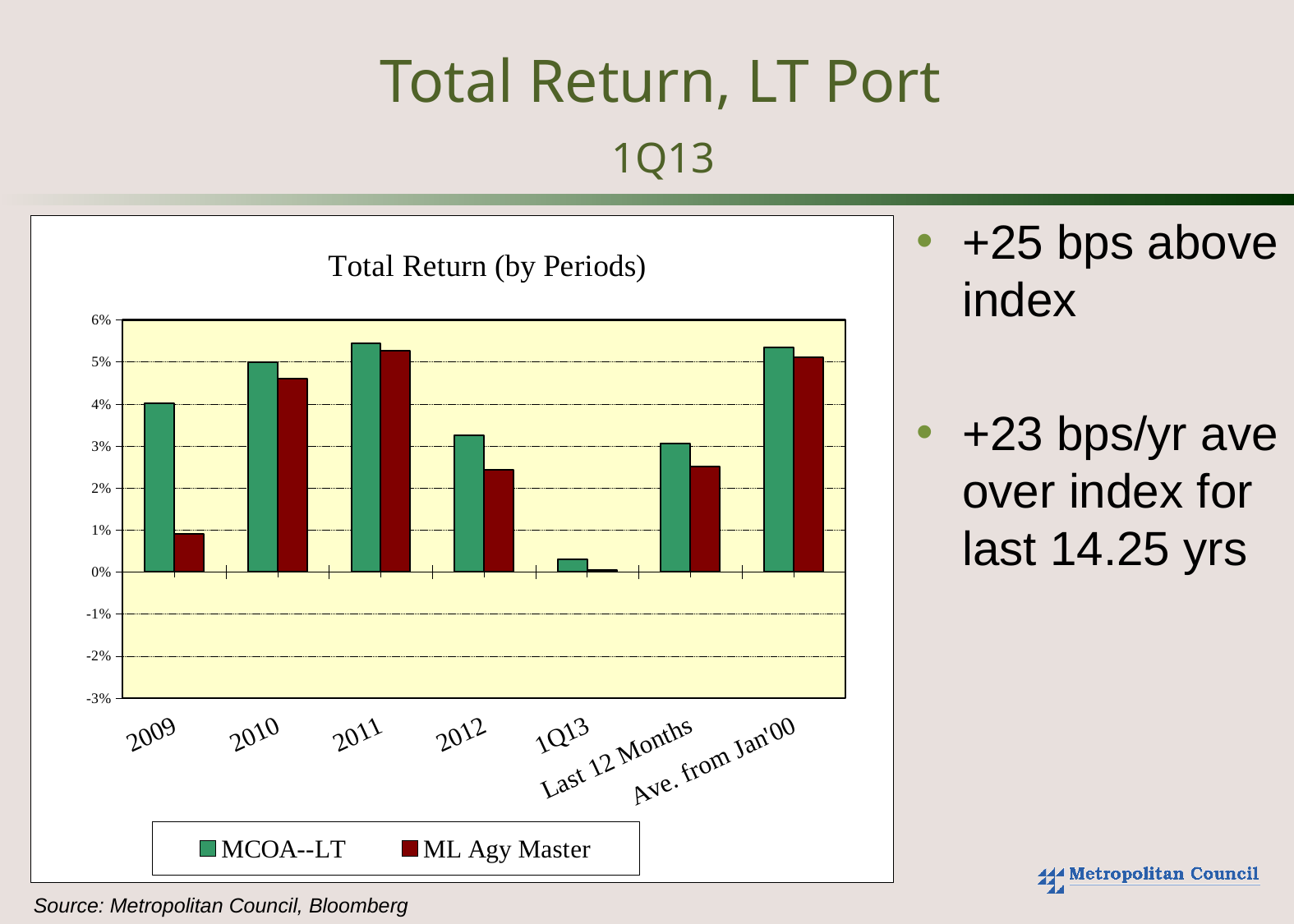
Is the MCOA--LT value for 2009 greater or less than 3%? greater In 2012, which series has the larger value, MCOA--LT or ML Agy Master? MCOA--LT What kind of chart is shown on the slide? bar chart What is the title of the chart? Total Return (by Periods) Is the ML Agy Master value for 2009 greater or less than 2%? less Is the ML Agy Master value for 2012 greater or less than 3%? less How many period categories are shown on the x axis of the chart? 7 Which period has the lowest value for ML Agy Master? 1Q13 Which period has the lowest value for MCOA--LT? 1Q13 In 2009, which series has the larger value, MCOA--LT or ML Agy Master? MCOA--LT How many series does the chart legend list? 2